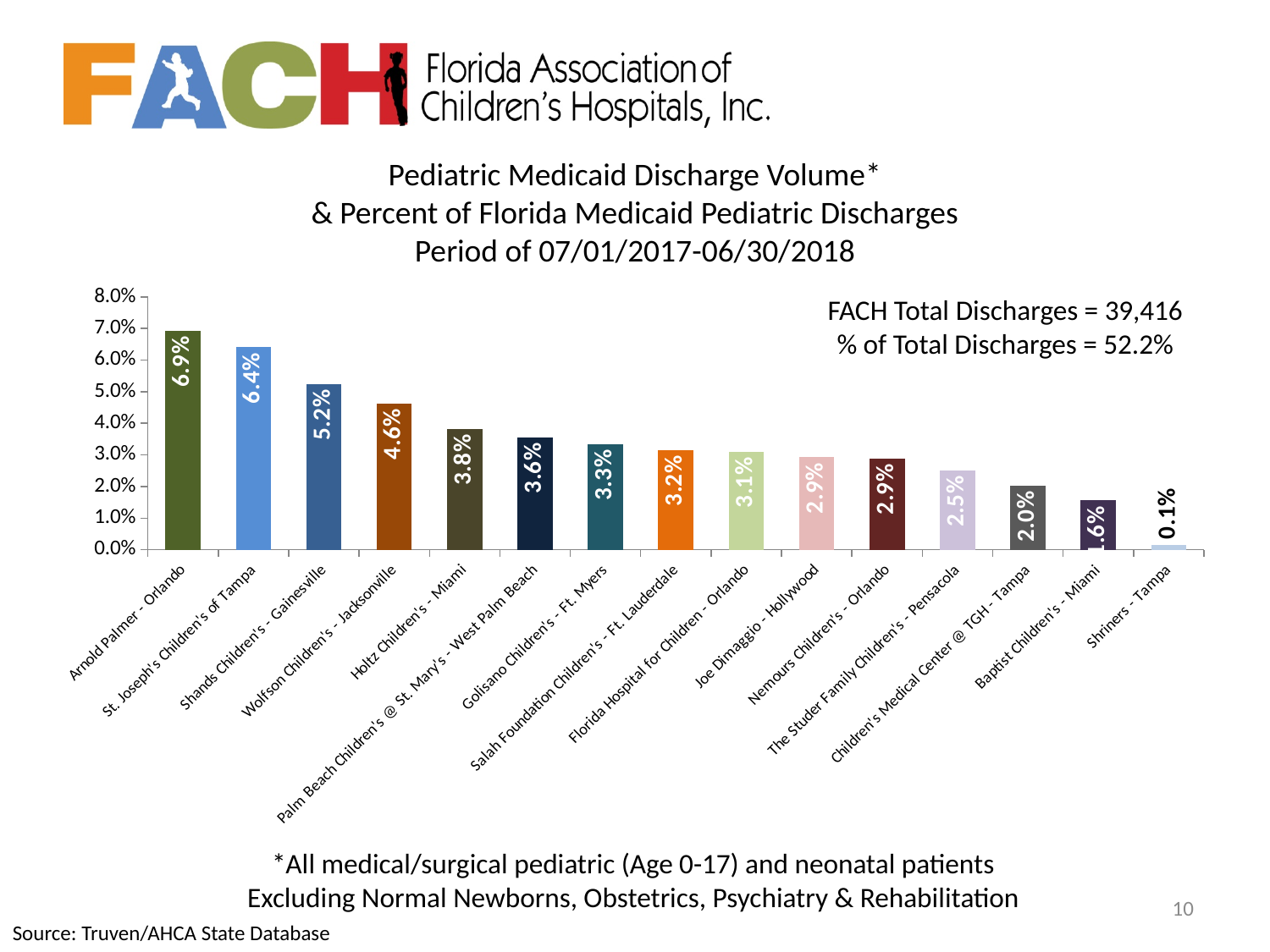
Do the values rise or fall moving from left to right along the x axis? Fall What is the FACH Total Discharges figure stated on the chart? 39,416 What value is shown for The Studer Family Children's - Pensacola? 2.5% What is the difference between the values for Arnold Palmer - Orlando and St. Joseph's Children's of Tampa? 0.5% Which hospital has the lowest percentage of Florida Medicaid pediatric discharges? Shriners - Tampa What kind of chart is shown on the slide? Bar chart Which hospital has the highest percentage of Florida Medicaid pediatric discharges? Arnold Palmer - Orlando What value is shown for Wolfson Children's - Jacksonville? 4.6% What percentage of Florida Medicaid pediatric discharges is shown for Arnold Palmer - Orlando? 6.9% Which has a larger value, Holtz Children's - Miami or Baptist Children's - Miami? Holtz Children's - Miami What value is shown for Golisano Children's - Ft. Myers? 3.3% How many hospitals are shown on the chart? 15